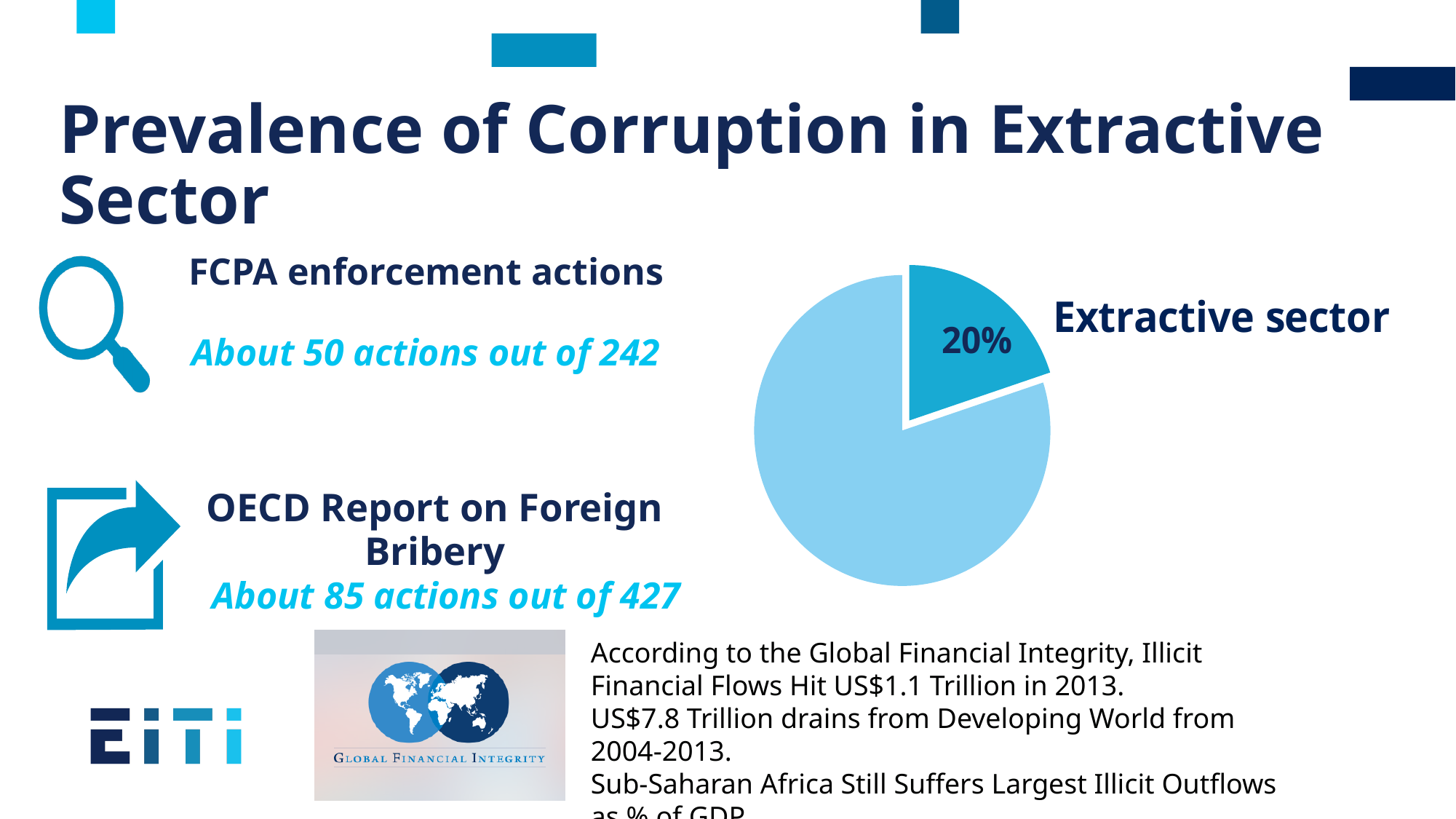
Which slice of the pie chart is the largest? the unlabeled light blue slice What share of the pie does the Extractive sector slice represent? 20% What label is shown next to the 20% slice of the pie chart? Extractive sector How many slices does the pie chart have? 2 What colour is the Extractive sector slice of the pie chart? darker (medium) blue What kind of chart is shown on the slide? pie chart What is the value printed on the darker slice of the pie chart? 20% Is the share of the Extractive sector slice greater or less than 50%? less Which slice of the pie chart is smaller, the Extractive sector slice or the unlabeled slice? Extractive sector